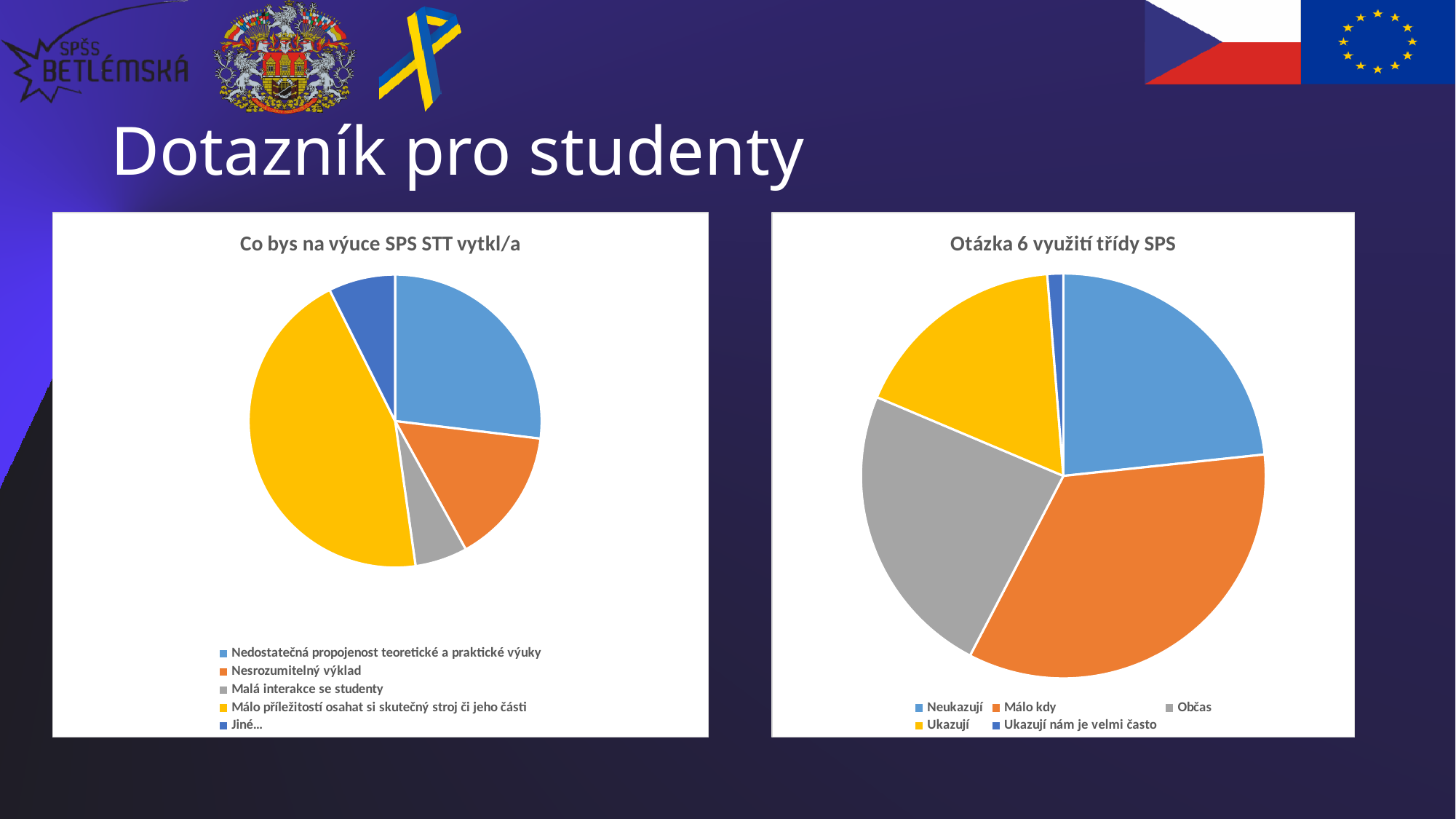
In the right chart "Otázka 6 využití třídy SPS", which category has the smallest slice? Ukazují nám je velmi často In the right chart "Otázka 6 využití třídy SPS", which category has the largest slice? Málo kdy What is the title of the left chart on the slide? Co bys na výuce SPS STT vytkl/a In the left chart "Co bys na výuce SPS STT vytkl/a", which category has the largest slice? Málo příležitostí osahat si skutečný stroj či jeho části What kind of chart is the right chart titled "Otázka 6 využití třídy SPS"? Pie chart In the right chart "Otázka 6 využití třídy SPS", how many categories does the legend list? 5 In the right chart "Otázka 6 využití třídy SPS", which slice is larger: "Občas" or "Ukazují"? Občas In the right chart "Otázka 6 využití třídy SPS", which slice is larger: "Neukazují" or "Ukazují"? Neukazují In the left chart "Co bys na výuce SPS STT vytkl/a", how many slices does the pie have? 5 What kind of chart is the left chart titled "Co bys na výuce SPS STT vytkl/a"? Pie chart In the right chart "Otázka 6 využití třídy SPS", which colour represents the category "Málo kdy"? Orange In the left chart "Co bys na výuce SPS STT vytkl/a", which slice is larger: "Nedostatečná propojenost teoretické a praktické výuky" or "Nesrozumitelný výklad"? Nedostatečná propojenost teoretické a praktické výuky